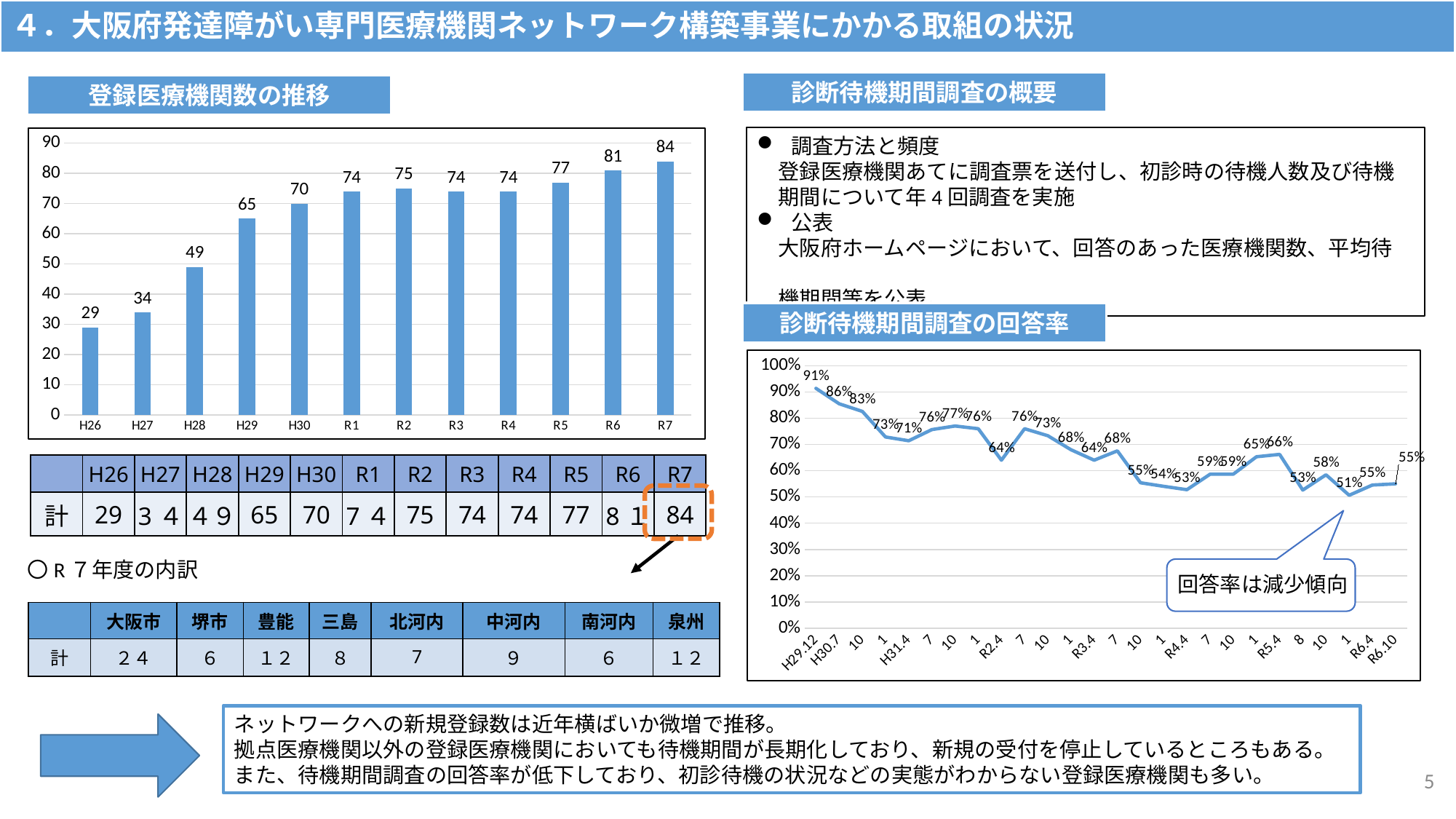
In the bar chart 登録医療機関数の推移, what is the value for H29? 65 In the bar chart 登録医療機関数の推移, what is the value for H26? 29 In the bar chart 登録医療機関数の推移, which category has the highest value? R7 How many categories are shown in the bar chart 登録医療機関数の推移? 12 In the bar chart 登録医療機関数の推移, what is the value for R7? 84 What kind of chart is 登録医療機関数の推移? bar chart In the bar chart 登録医療機関数の推移, which category has the lowest value? H26 In the line chart 診断待機期間調査の回答率, what is the highest value shown? 91% In the bar chart 登録医療機関数の推移, what is the difference between the values for R7 and H26? 55 In the bar chart 登録医療機関数の推移, which is larger, the value for H28 or the value for H30? H30 In the line chart 診断待機期間調査の回答率, do the values generally rise or fall along the x axis? fall In the line chart 診断待機期間調査の回答率, what is the value for H29.12? 91%